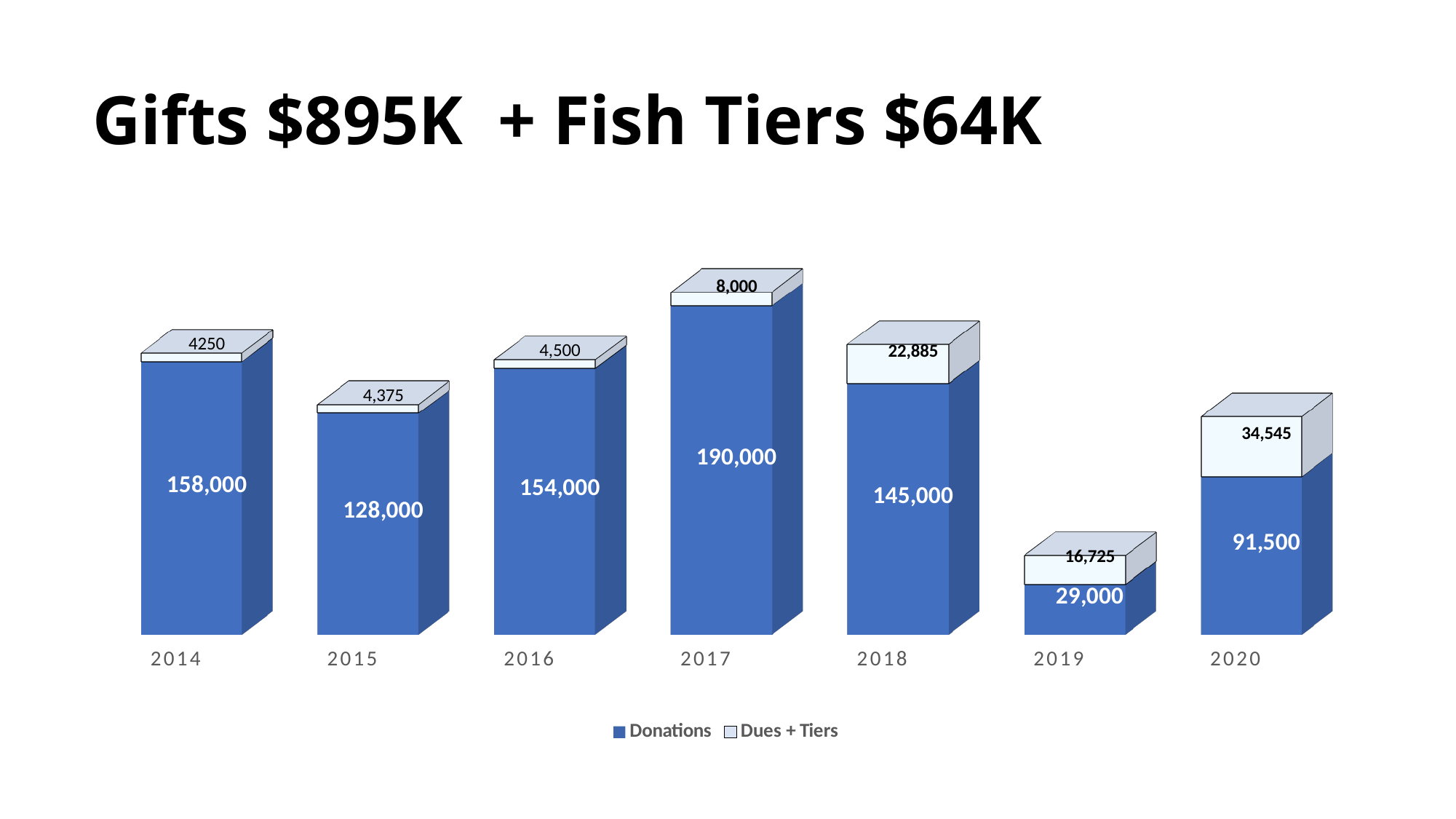
How many years are shown on the x axis? 7 What is the Dues + Tiers value for 2018? 22,885 What is the Donations value for 2017? 190,000 What is the total of the stacked bar for 2019? 45,725 Which year has the lowest Donations value? 2019 Which year has the highest Donations value? 2017 How many series does the legend list? 2 What is the Donations value for 2020? 91,500 Which is larger, the Donations value for 2014 or for 2016? 2014 What is the difference between the Donations values for 2017 and 2018? 45,000 Which year has the highest Dues + Tiers value? 2020 What kind of chart is shown on the slide? Stacked bar chart